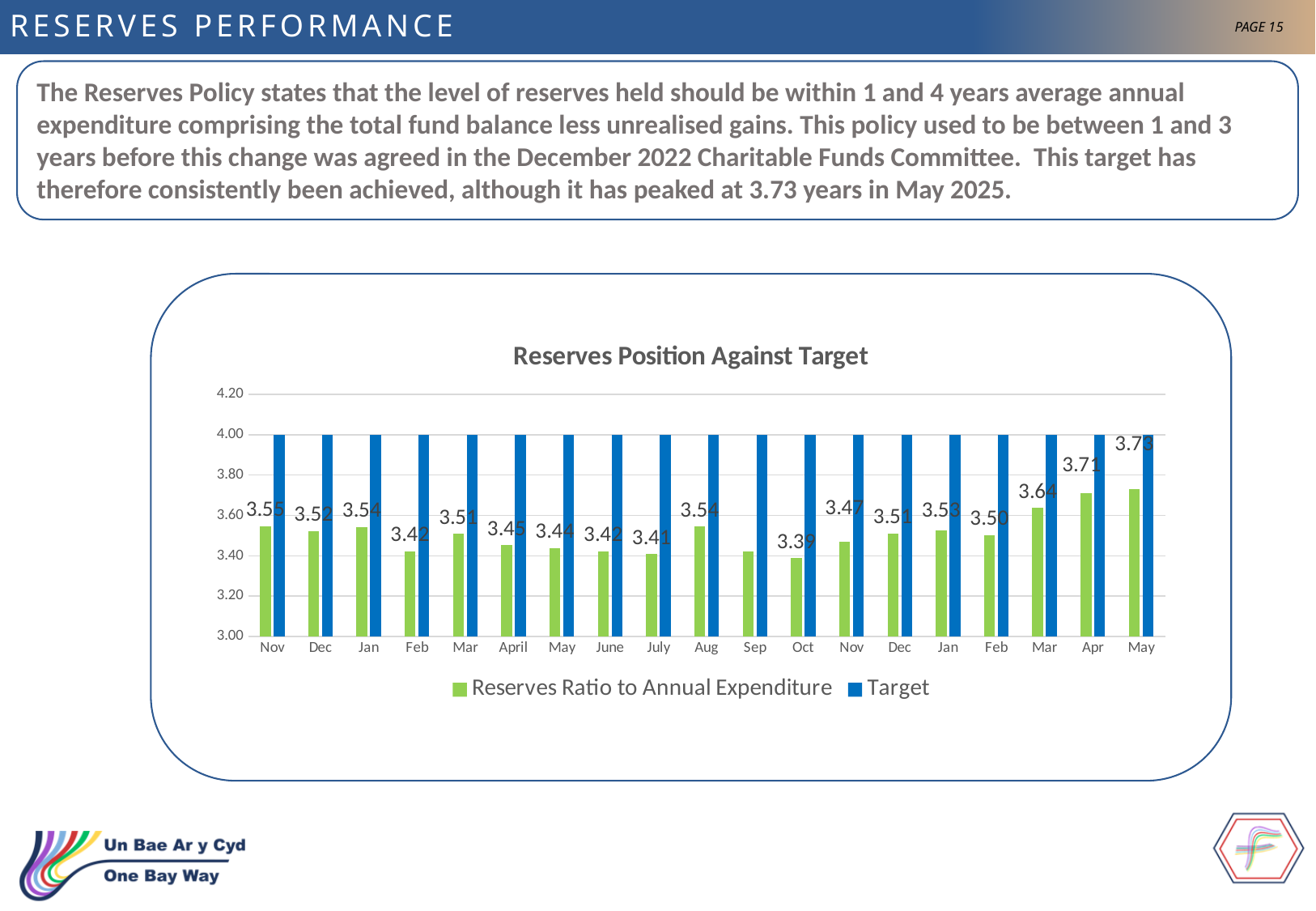
What is the Reserves Ratio to Annual Expenditure for the final May on the x axis? 3.73 Is the Target value for each month greater or less than 3.80? greater What is the difference between the Reserves Ratio to Annual Expenditure for Aug and for July? 0.13 How many series does the legend list? 2 What type of chart is 'Reserves Position Against Target'? Bar chart Which month has the highest Reserves Ratio to Annual Expenditure? May (the last category) What is the Reserves Ratio to Annual Expenditure for April? 3.45 Which month has the lowest Reserves Ratio to Annual Expenditure? Oct What is the Reserves Ratio to Annual Expenditure for Oct? 3.39 How many months are shown on the x axis of the chart? 19 Is the Reserves Ratio to Annual Expenditure for Sep greater or less than 3.60? less Which is larger, the Reserves Ratio to Annual Expenditure for June or for Aug? Aug